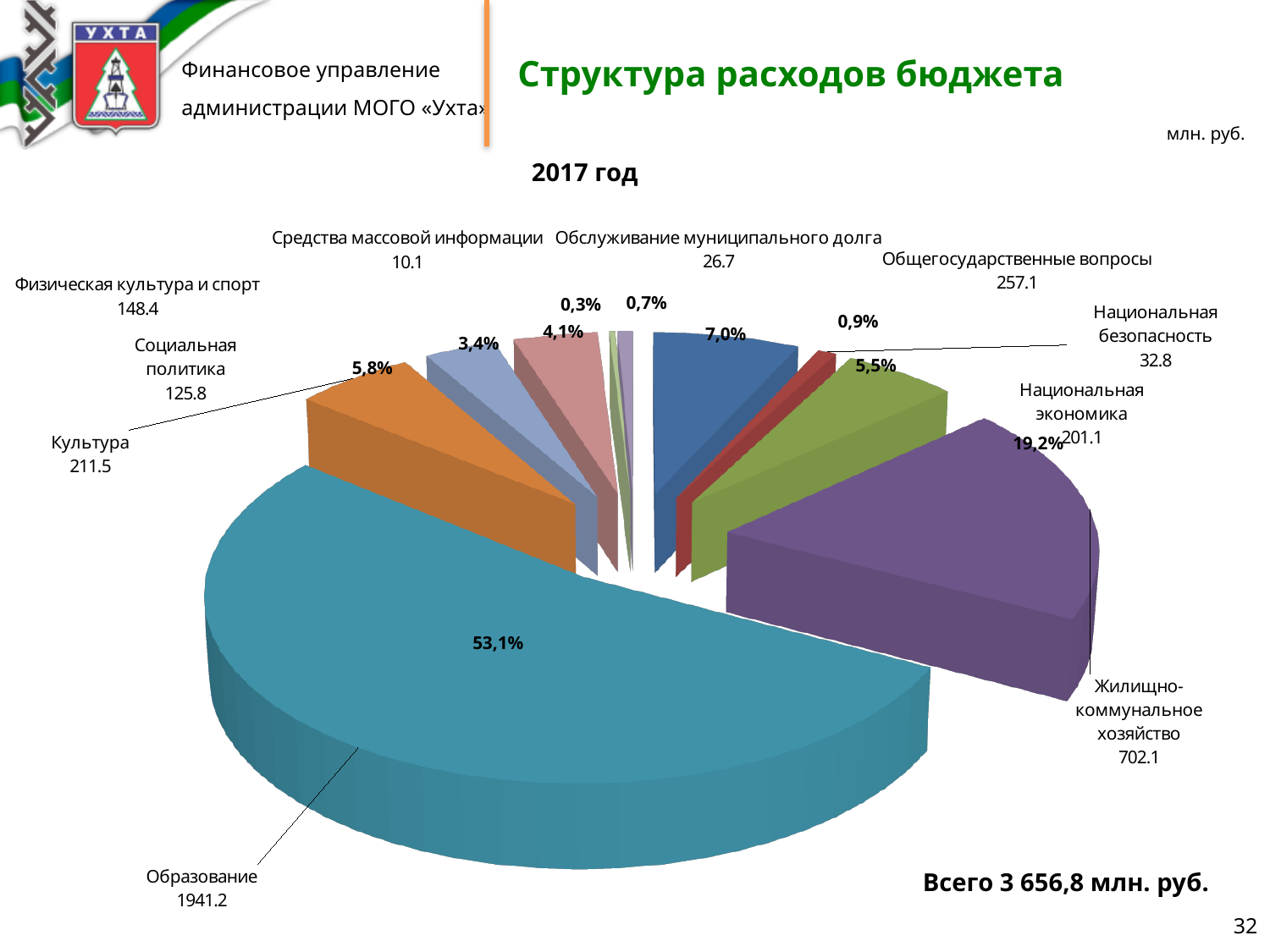
What kind of chart is shown on the slide? Pie chart What is the value for Жилищно-коммунальное хозяйство? 702.1 What total is stated on the slide for the budget expenditures? 3 656,8 млн. руб. What is the value for Национальная безопасность? 32.8 What is the value for Образование? 1941.2 What share of the pie does Образование take? 53,1% Which category has the largest value? Образование Which is larger, the value for Культура or the value for Физическая культура и спорт? Культура What is the difference between the values for Общегосударственные вопросы and Национальная экономика? 56.0 How many categories are shown in the pie chart? 10 What share of the pie does Жилищно-коммунальное хозяйство take? 19,2% Which category has the smallest value? Средства массовой информации